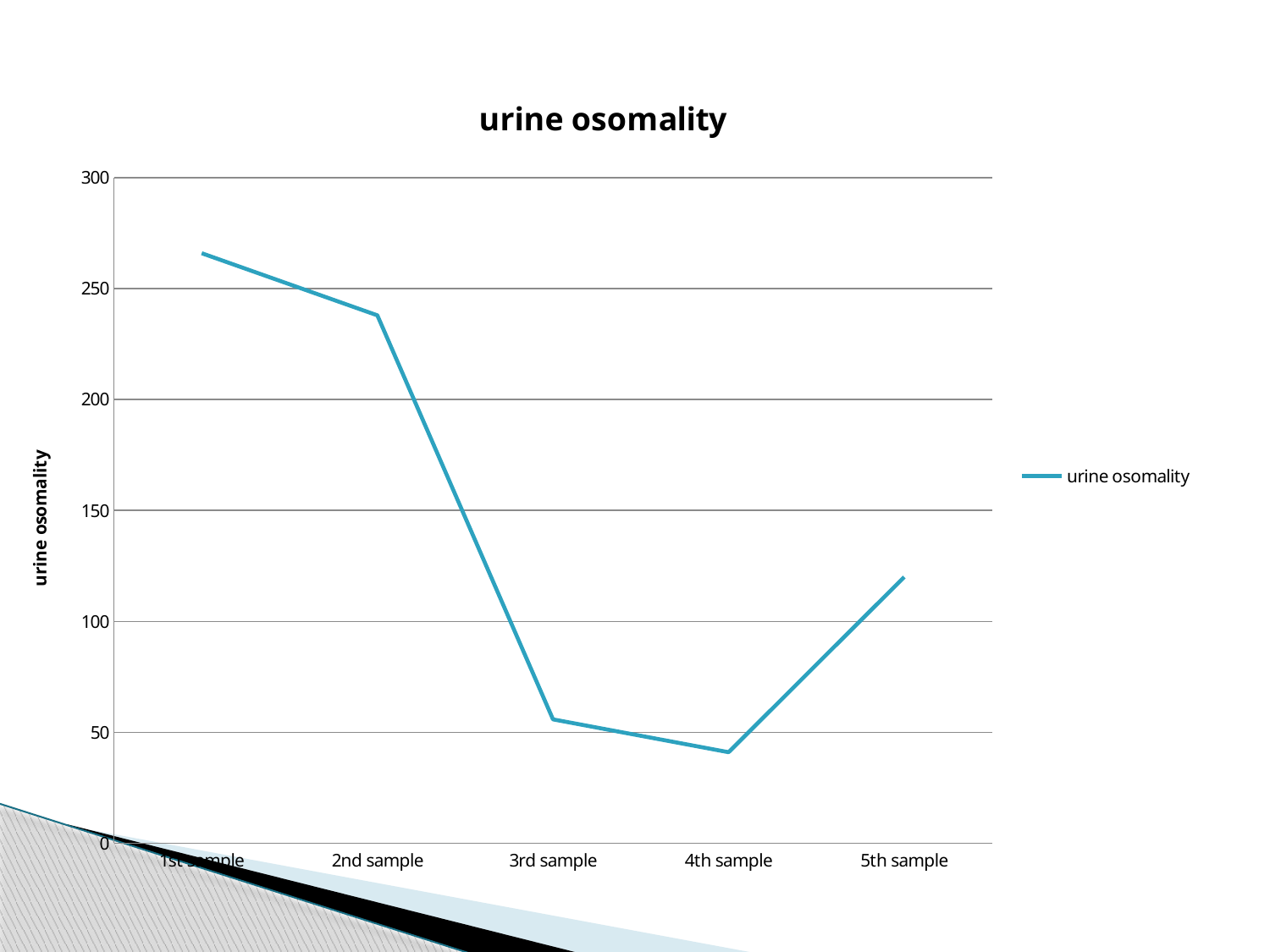
Is the value for 1st sample greater or less than 250? greater Which sample has the lowest urine osomality value? 4th sample How many series does the legend list? 1 Do the values rise or fall from 1st sample to 4th sample? fall Is the value for 5th sample greater or less than 100? greater What is the title of the chart? urine osomality Which is larger, the value for 2nd sample or the value for 5th sample? 2nd sample How many samples are plotted along the x axis? 5 Is the value for 2nd sample greater or less than 250? less Which sample has the highest urine osomality value? 1st sample What kind of chart is shown on the slide? line chart